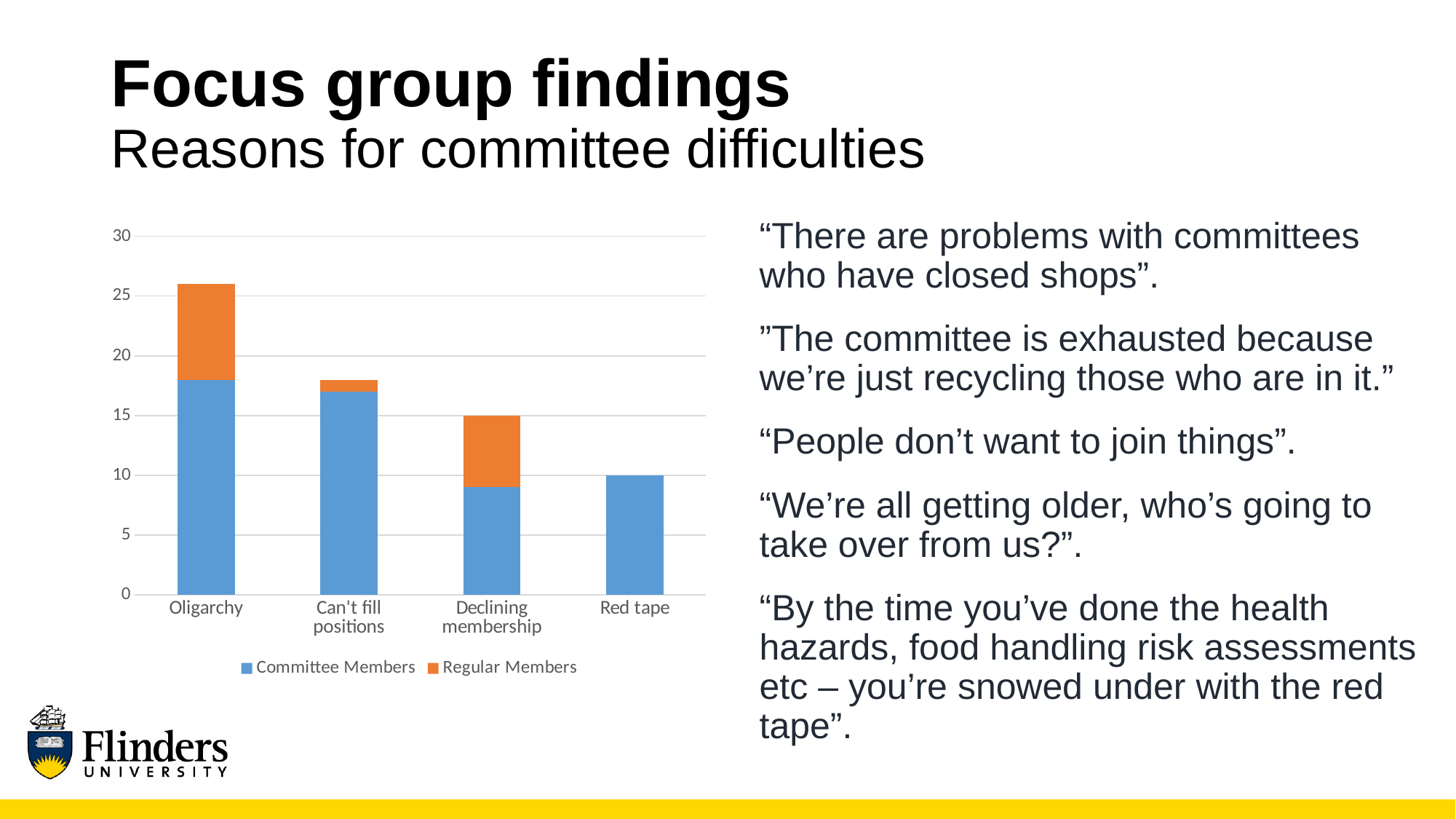
Which is larger, the total for Can't fill positions or the total for Declining membership? Can't fill positions Which category has the shortest stacked bar in the chart? Red tape Which category has no Regular Members segment in its bar? Red tape Which category has the tallest stacked bar in the chart? Oligarchy What is the total height of the Declining membership stacked bar? 15 How many categories are shown on the x axis of the chart? 4 What is the total height of the Red tape bar? 10 Is the Committee Members value for Declining membership greater or less than 10? less Is the total value for Oligarchy greater or less than 25? greater What kind of chart is shown on the slide? Stacked bar chart How many series does the chart legend list? 2 Which colour represents Regular Members in the chart legend? Orange